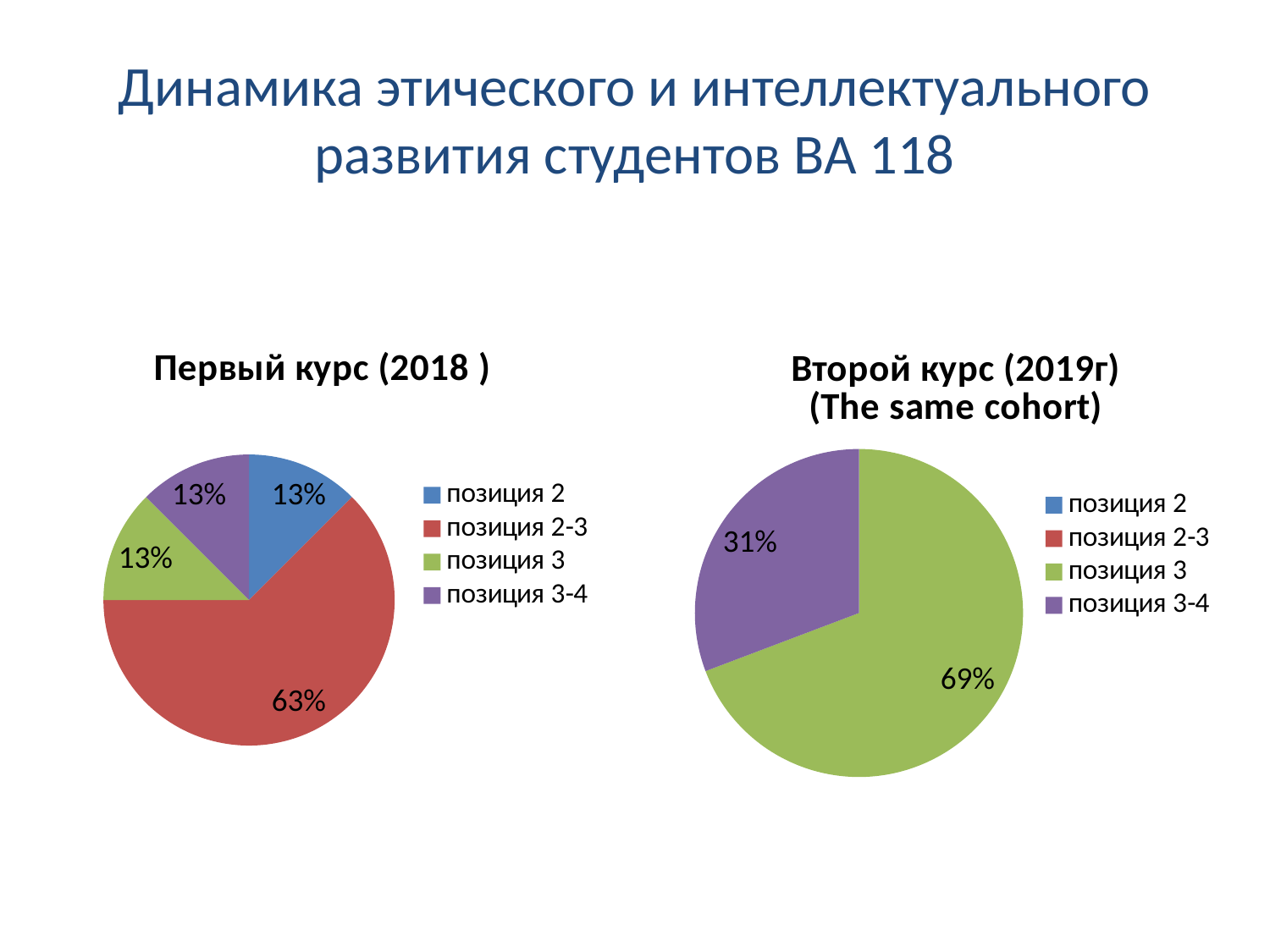
What type of chart is the 'Первый курс (2018 )' chart? Pie chart In the 'Второй курс (2019г) (The same cohort)' chart, which is larger: 'позиция 3' or 'позиция 3-4'? позиция 3 In the 'Второй курс (2019г) (The same cohort)' chart, what share does 'позиция 3' have? 69% In the 'Второй курс (2019г) (The same cohort)' chart, what is the value for 'позиция 3-4'? 31% In the 'Первый курс (2018 )' chart, what share does 'позиция 2-3' have? 63% In the 'Второй курс (2019г) (The same cohort)' chart, which category has the largest slice? позиция 3 In the 'Второй курс (2019г) (The same cohort)' chart, what is the difference between 'позиция 3' and 'позиция 3-4'? 38% In the 'Первый курс (2018 )' chart, what is the difference between 'позиция 2-3' and 'позиция 3'? 50% How many entries does the legend of the 'Первый курс (2018 )' chart list? 4 In the 'Первый курс (2018 )' chart, which category has the largest slice? позиция 2-3 How many slices are visible in the 'Второй курс (2019г) (The same cohort)' pie chart? 2 In the 'Первый курс (2018 )' chart, what is the value for 'позиция 2'? 13%